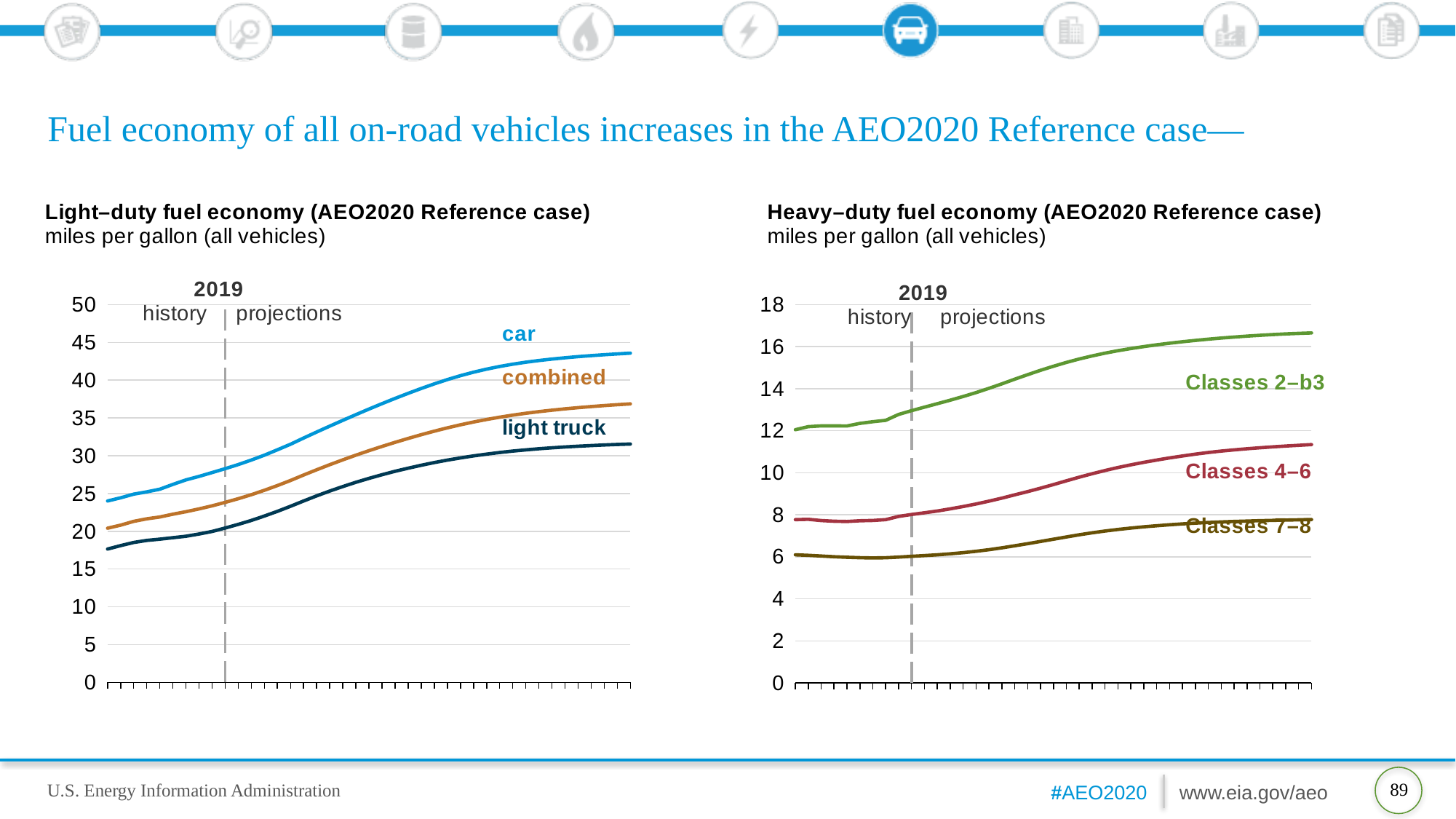
On the Heavy-duty fuel economy chart, which is larger at the end of the projection period, Classes 2-b3 or Classes 4-6? Classes 2-b3 What kind of chart is the Light-duty fuel economy chart? line chart On the Light-duty fuel economy chart, do the car values rise or fall over the projection period? rise What unit is used on the y axis of the Heavy-duty fuel economy chart? miles per gallon On the Heavy-duty fuel economy chart, is the value for Classes 4-6 at the end of the projection period greater or less than 10? greater How many series are plotted on the Light-duty fuel economy chart? 3 On the Light-duty fuel economy chart, which series has the lowest values throughout? light truck On the Light-duty fuel economy chart, which series has the highest values at the end of the projection period? car How many series are plotted on the Heavy-duty fuel economy chart? 3 On the Light-duty fuel economy chart, is the value for car at the end of the projection period greater or less than 40? greater On the Heavy-duty fuel economy chart, which series has the highest values? Classes 2-b3 On the Heavy-duty fuel economy chart, which series has the lowest values? Classes 7-8